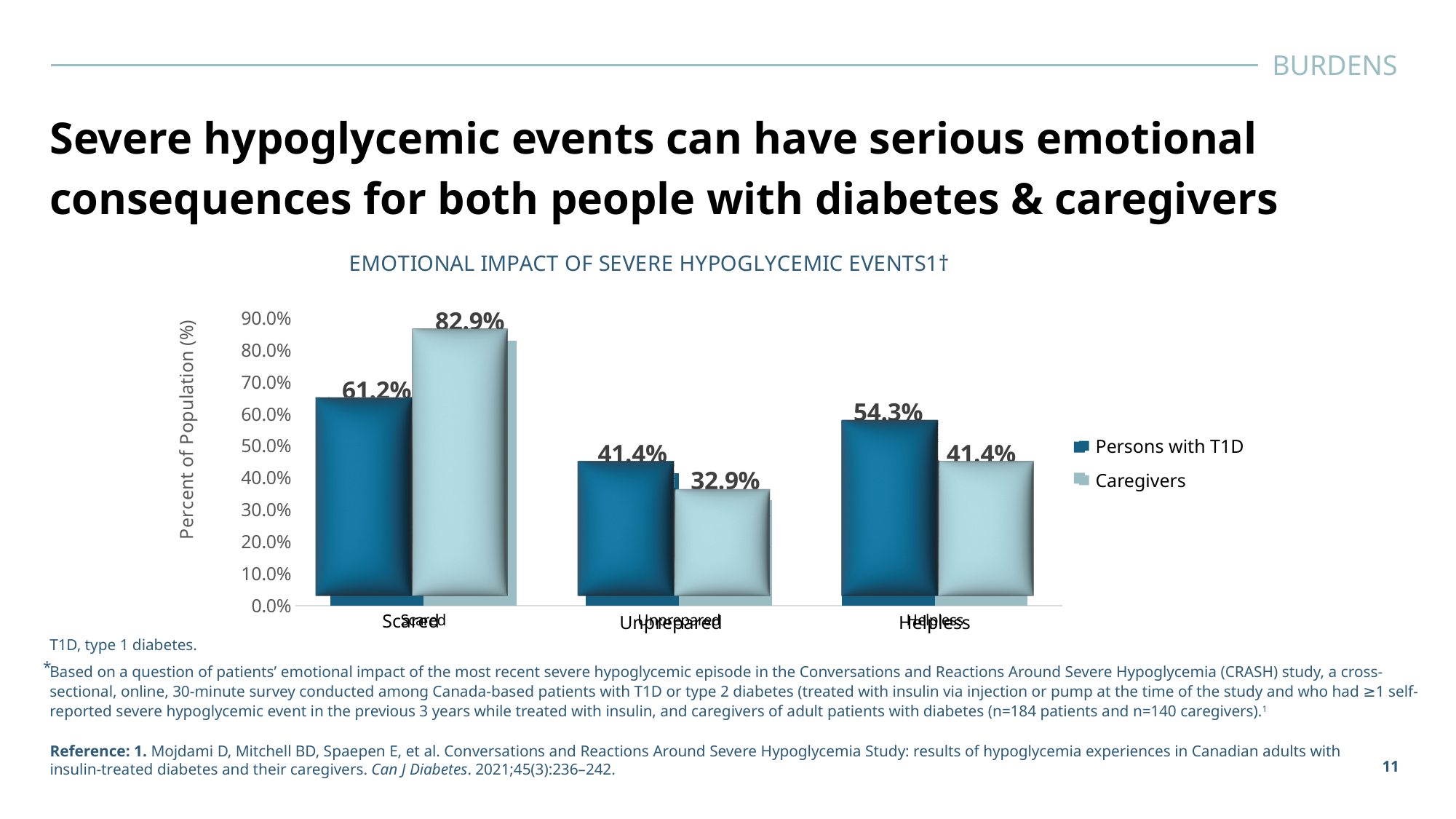
How many emotional categories are shown on the x axis? 3 What is the difference between the Caregivers and Persons with T1D values for Scared? 21.7% What percentage of Caregivers reported feeling Scared? 82.9% Which category has the lowest value for Persons with T1D? Unprepared What percentage of Persons with T1D reported feeling Scared? 61.2% How many series does the legend list? 2 What is the label of the y axis? Percent of Population (%) Which category has the highest value for Caregivers? Scared What is the value for Caregivers in the Unprepared category? 32.9% In the Helpless category, which series has the larger value, Persons with T1D or Caregivers? Persons with T1D What is the value for Persons with T1D in the Helpless category? 54.3% What kind of chart is shown on the slide? Bar chart